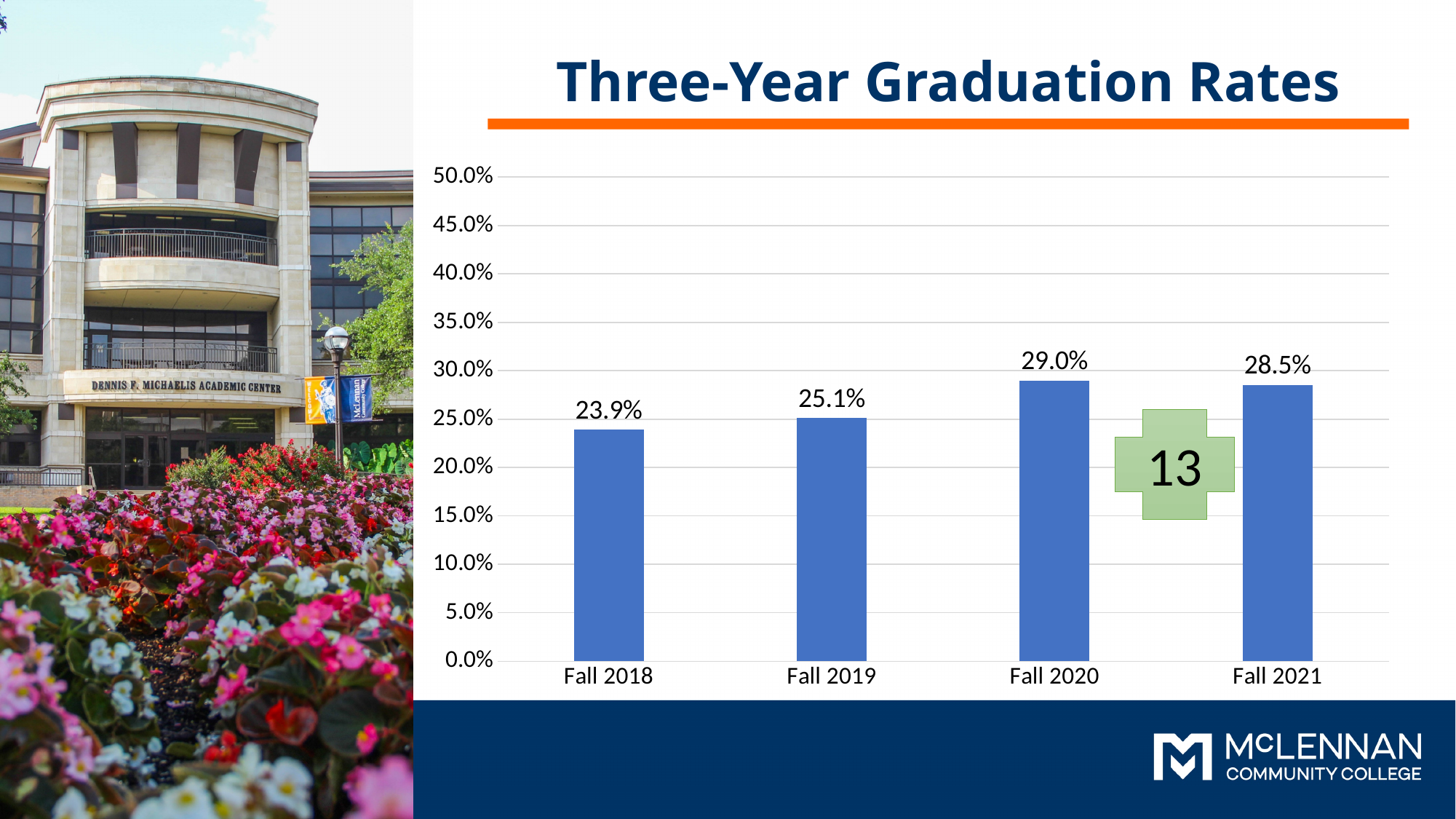
What is the three-year graduation rate for Fall 2018? 23.9% How many cohorts are shown in the chart? 4 What is the three-year graduation rate for Fall 2019? 25.1% Which cohort has the lowest three-year graduation rate? Fall 2018 Which cohort has the highest three-year graduation rate? Fall 2020 What is the three-year graduation rate for Fall 2021? 28.5% Is the graduation rate for Fall 2018 greater or less than 25.0%? less What is the title of the chart? Three-Year Graduation Rates What is the three-year graduation rate for Fall 2020? 29.0% Which has a higher graduation rate, Fall 2019 or Fall 2021? Fall 2021 What is the difference in graduation rate between Fall 2020 and Fall 2018? 5.1% What kind of chart is shown on the slide? Bar chart